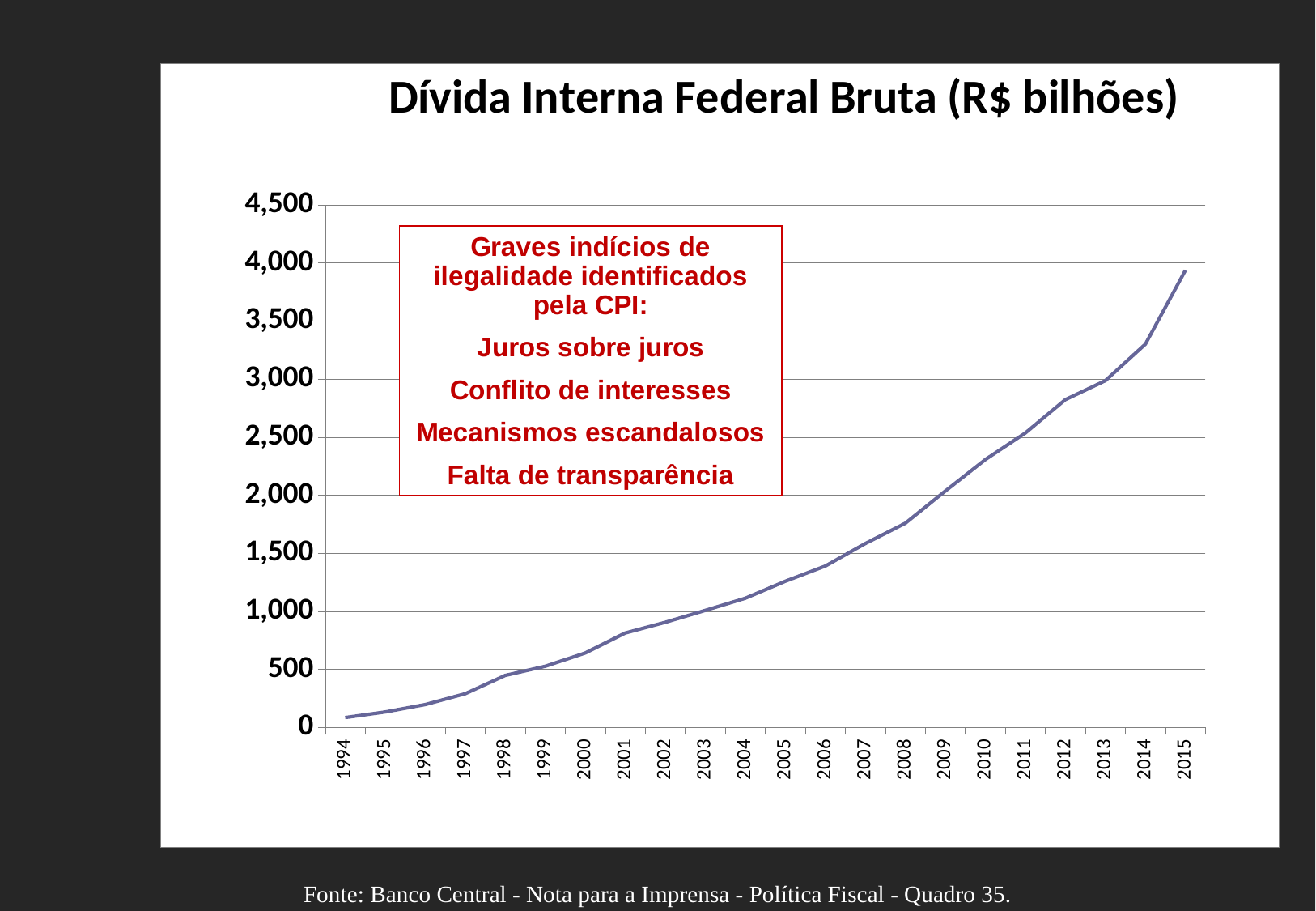
Is the value for 2012 greater or less than 3,000? less Which year has the highest value? 2015 Do the values rise or fall from 1994 to 2015? rise What is the title of the chart? Dívida Interna Federal Bruta (R$ bilhões) How many years are plotted along the x axis? 22 Is the value for 1994 greater or less than 500? less Which is larger, the value for 2010 or the value for 2005? 2010 Which year has the lowest value? 1994 What kind of chart is shown on the slide? line chart Is the value for 2008 greater or less than 1,500? greater